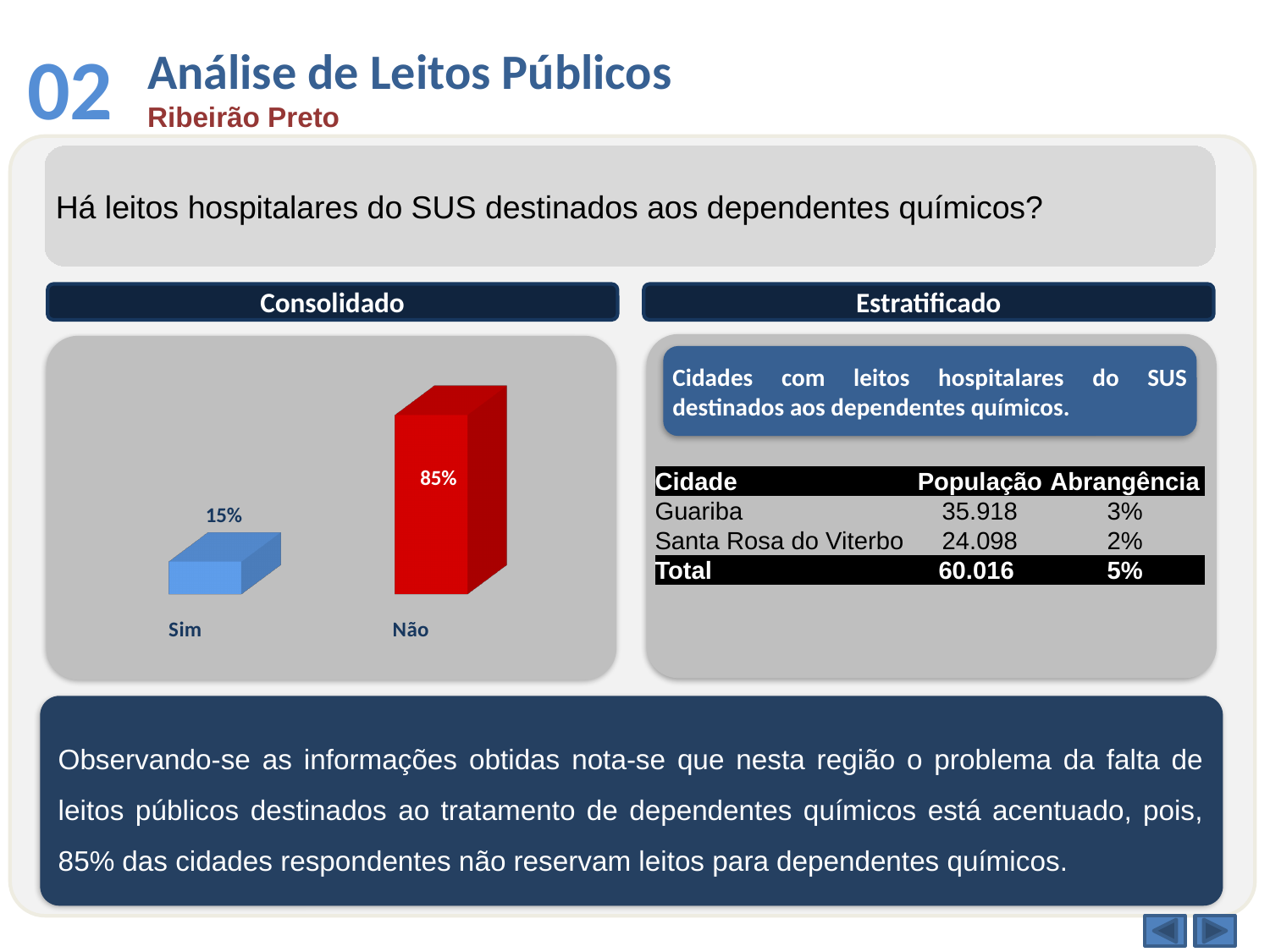
What kind of chart is shown under the 'Consolidado' heading? Bar chart How many categories are plotted in the chart? 2 What colour is the 'Não' bar in the chart? Red Which is larger in the chart, the value for 'Sim' or the value for 'Não'? Não What is the value shown for the 'Não' bar in the chart? 85% What is the value shown for the 'Sim' bar in the chart? 15% What is the difference between the 'Não' and 'Sim' values in the chart? 70 percentage points Do the values rise or fall going from 'Sim' to 'Não' along the x axis? Rise Which category has the lowest value in the chart? Sim Which category has the highest value in the chart? Não What colour is the 'Sim' bar in the chart? Blue